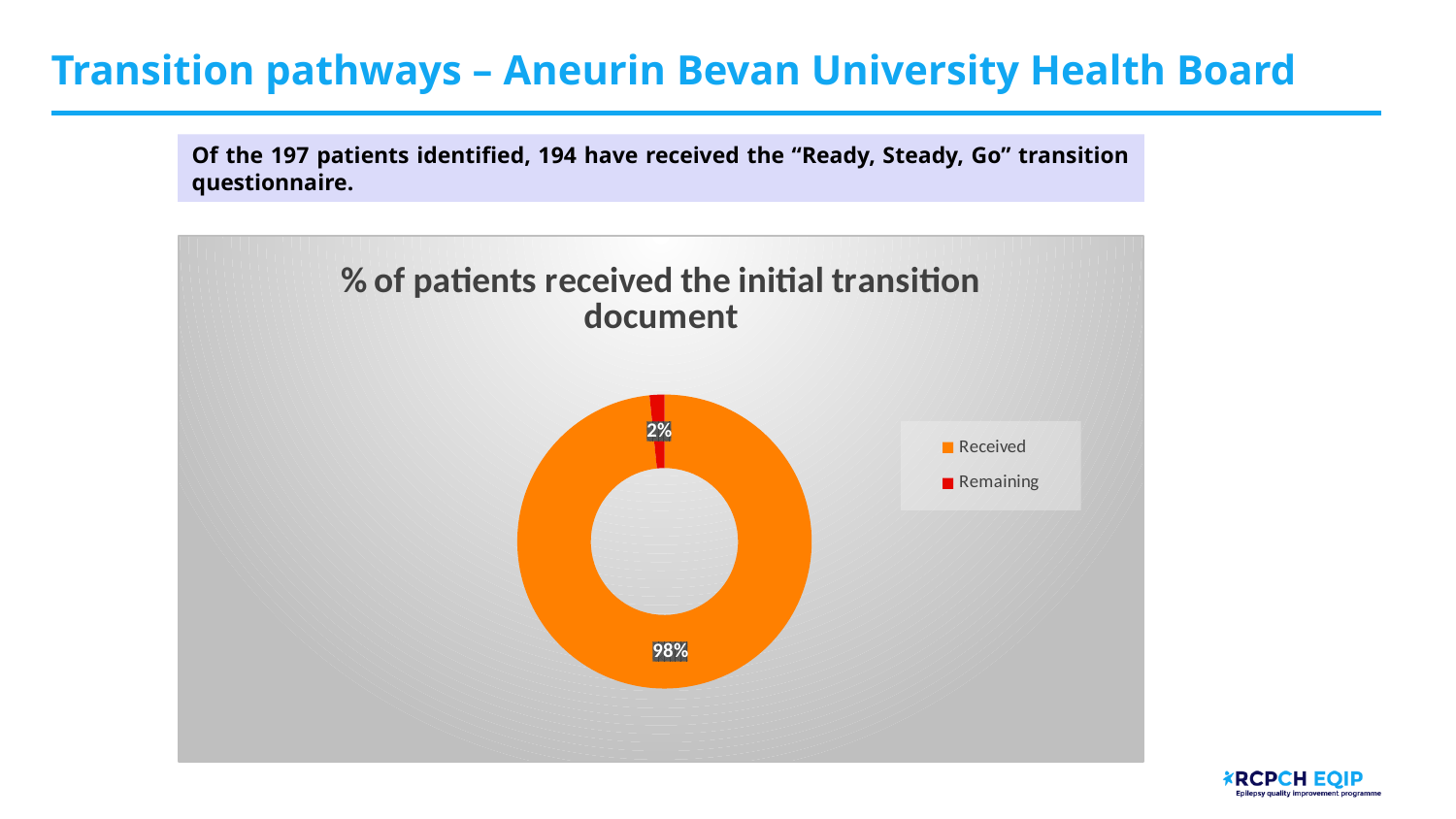
Which is larger, the Received slice or the Remaining slice? Received What kind of chart is shown on the slide? Doughnut (pie) chart What colour represents the Remaining category in the chart? Red What percentage is shown for the Remaining slice? 2% Which category has the smallest share of the chart? Remaining Which category has the largest share of the chart? Received What is the difference in percentage points between the Received and Remaining slices? 96 What percentage of patients received the initial transition document? 98% What share of the chart does the Received slice represent? 98% How many categories does the chart show? 2 What is the title of the chart? % of patients received the initial transition document How many entries does the legend list? 2